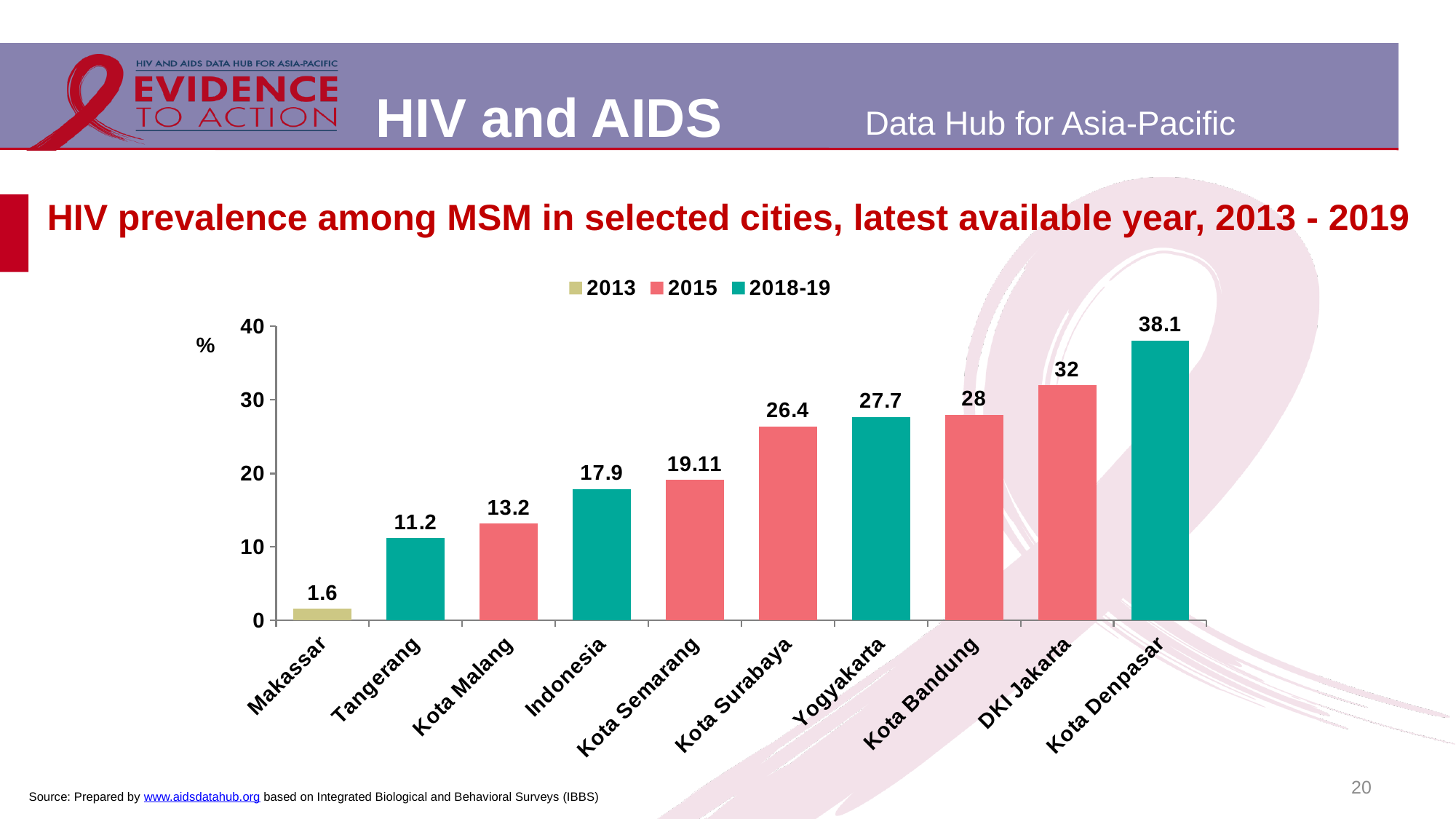
Which has a higher HIV prevalence among MSM, Yogyakarta or Kota Surabaya? Yogyakarta Which city has the lowest HIV prevalence among MSM on the chart? Makassar How many series does the legend list? 3 What is the HIV prevalence among MSM in Kota Semarang? 19.11 What is the difference between the HIV prevalence values for DKI Jakarta and Kota Bandung? 4 How many cities or locations are shown on the x axis of the chart? 10 Which city has the highest HIV prevalence among MSM on the chart? Kota Denpasar What is the HIV prevalence among MSM in Makassar? 1.6 What is the HIV prevalence among MSM in Kota Denpasar? 38.1 What kind of chart is shown on the slide? bar chart Which legend series does the Makassar bar belong to? 2013 Is the value for Indonesia greater or less than 20? less